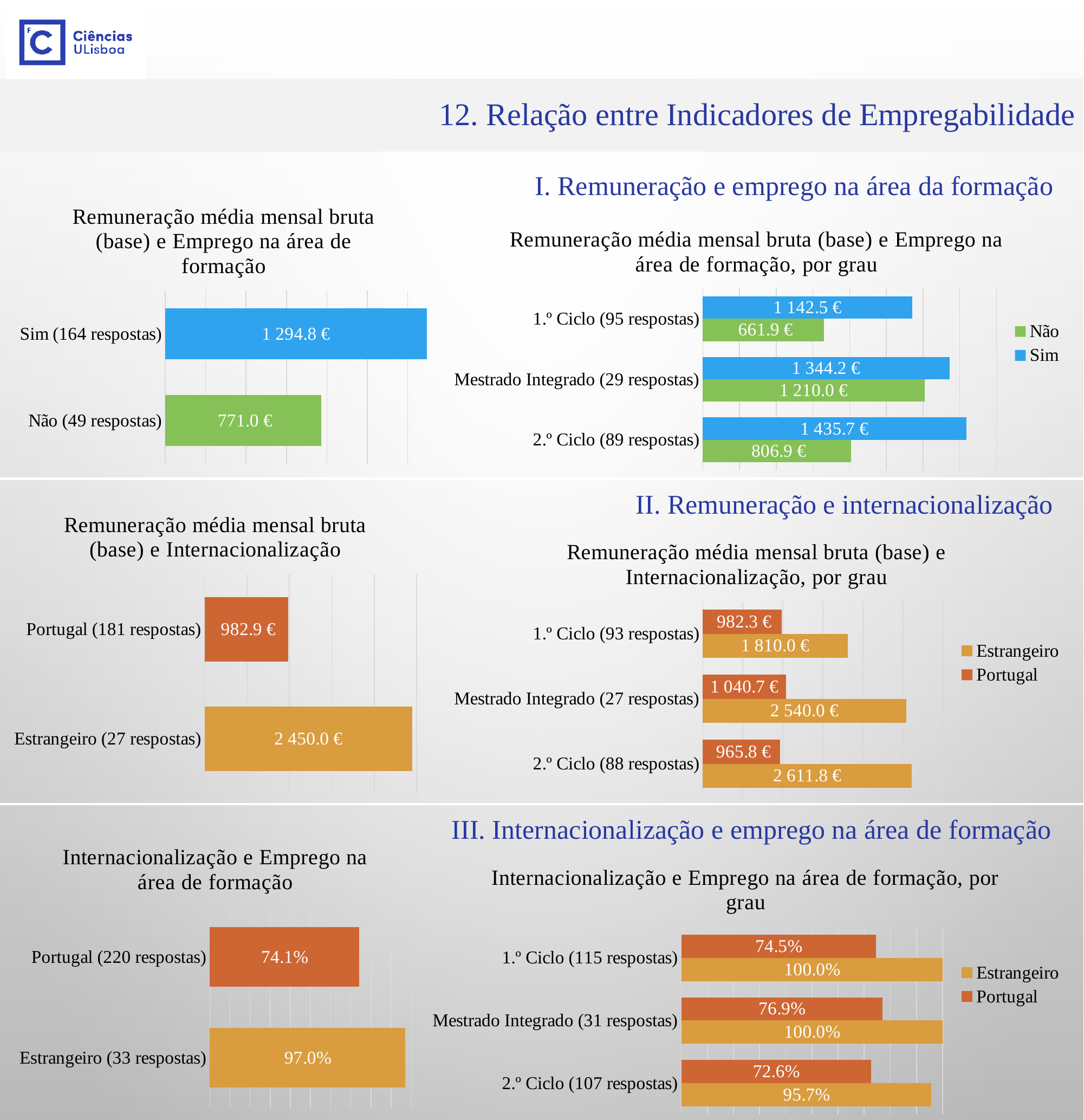
In the chart titled "Remuneração média mensal bruta (base) e Emprego na área de formação" (top left), what is the value for Sim (164 respostas)? 1 294.8 € In the chart titled "Internacionalização e Emprego na área de formação, por grau" (bottom right), what is the Estrangeiro value for 2.º Ciclo (107 respostas)? 95.7% In the chart titled "Remuneração média mensal bruta (base) e Emprego na área de formação, por grau" (top right), how many series does the legend list? 2 In the chart titled "Remuneração média mensal bruta (base) e Emprego na área de formação" (top left), what is the difference between the Sim and Não values? 523.8 € In the chart titled "Remuneração média mensal bruta (base) e Internacionalização" (middle left), what is the value for Estrangeiro (27 respostas)? 2 450.0 € In the chart titled "Internacionalização e Emprego na área de formação" (bottom left), what is the value for Portugal (220 respostas)? 74.1% In the chart titled "Remuneração média mensal bruta (base) e Emprego na área de formação, por grau" (top right), which category has the highest Sim value? 2.º Ciclo (89 respostas) What kind of chart is the chart titled "Internacionalização e Emprego na área de formação, por grau" (bottom right)? Bar chart In the chart titled "Remuneração média mensal bruta (base) e Emprego na área de formação, por grau" (top right), what is the Não value for 1.º Ciclo (95 respostas)? 661.9 € In the chart titled "Internacionalização e Emprego na área de formação" (bottom left), which is larger, the value for Portugal or for Estrangeiro? Estrangeiro In the chart titled "Remuneração média mensal bruta (base) e Internacionalização, por grau" (middle right), what is the Estrangeiro value for Mestrado Integrado (27 respostas)? 2 540.0 € In the chart titled "Remuneração média mensal bruta (base) e Internacionalização, por grau" (middle right), which category has the lowest Portugal value? 2.º Ciclo (88 respostas)